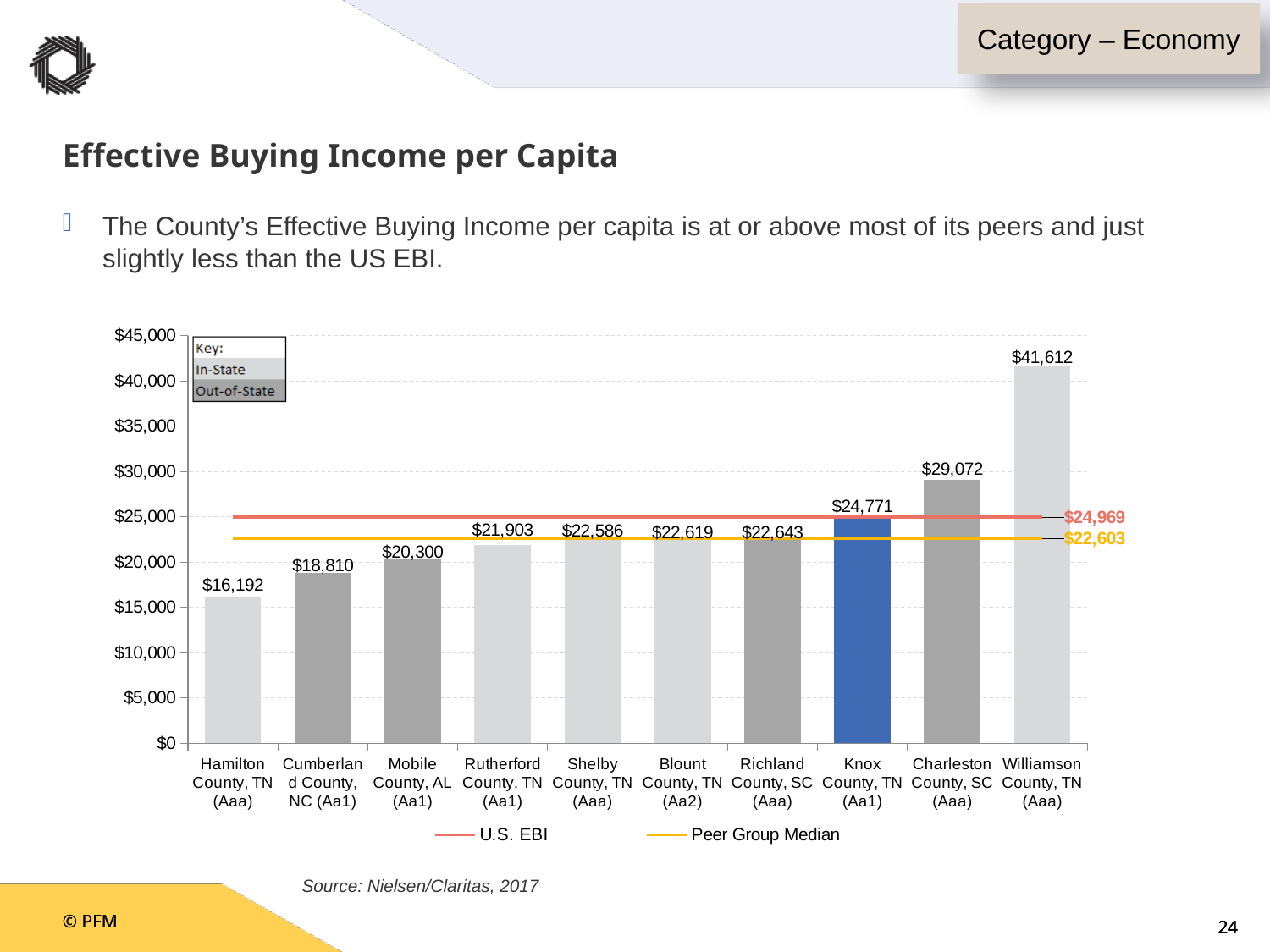
What is the Effective Buying Income per capita for Hamilton County, TN (Aaa)? $16,192 Do the bar values generally rise or fall from left to right across the chart? Rise What is the source cited for the chart data? Nielsen/Claritas, 2017 Which county has the highest Effective Buying Income per capita? Williamson County, TN (Aaa) What is the Effective Buying Income per capita for Knox County, TN (Aa1)? $24,771 Which has a higher Effective Buying Income per capita, Mobile County, AL or Rutherford County, TN? Rutherford County, TN How many counties are shown on the chart? 10 What value is shown for the Peer Group Median line? $22,603 What is the difference between the Effective Buying Income per capita of Williamson County, TN and Charleston County, SC? $12,540 What value is shown for the U.S. EBI line? $24,969 Which county has the lowest Effective Buying Income per capita? Hamilton County, TN (Aaa) What type of chart is used to show Effective Buying Income per Capita? Bar chart